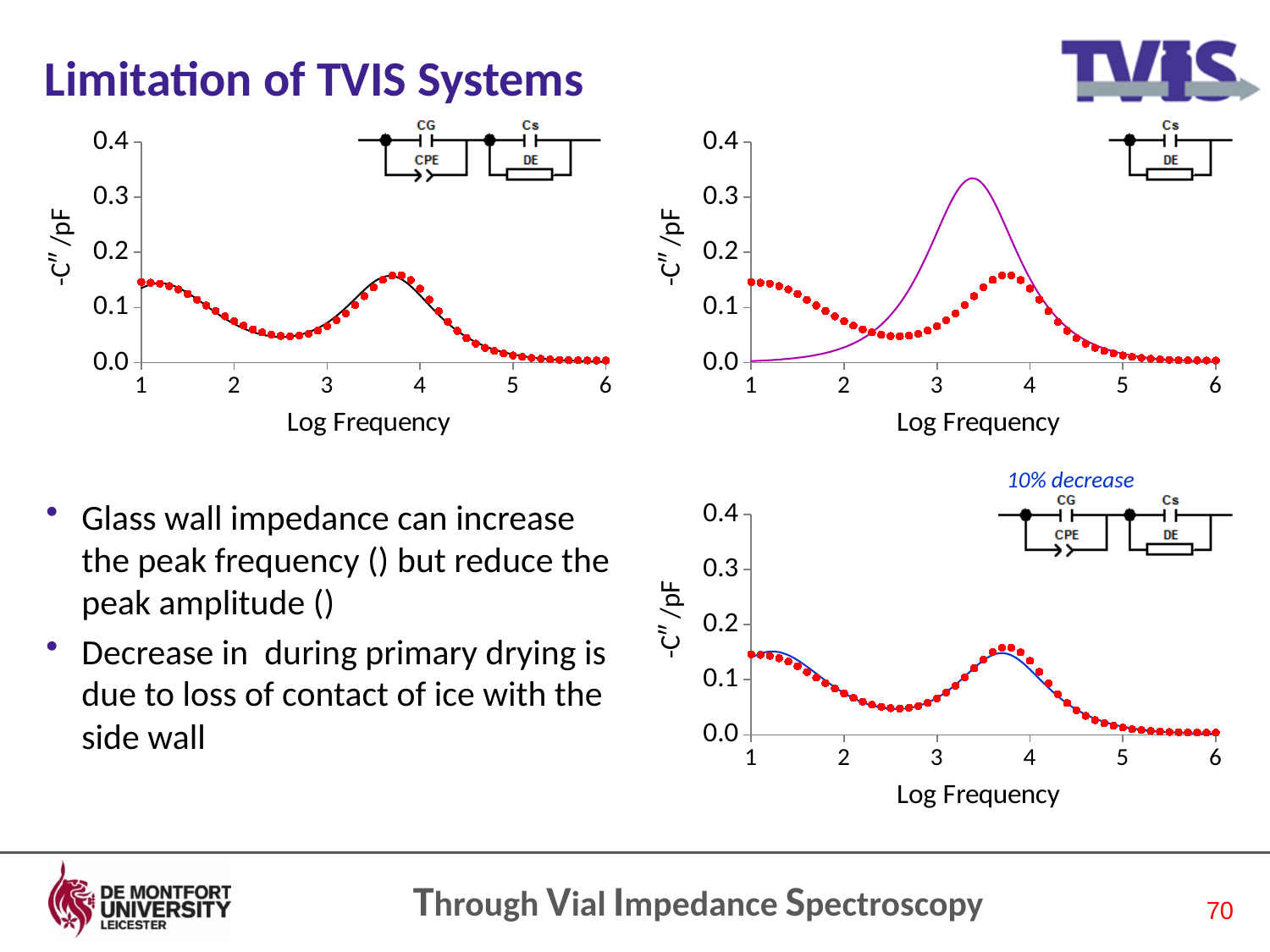
What is the x-axis label of the top-right chart? Log Frequency In the top-right chart, is the peak value of the purple line greater or less than 0.3? greater What kind of chart is the top-left chart on the slide? line chart In the top-left chart, do the values of the red dotted series rise or fall between log frequency 1 and log frequency 2.5? fall In the top-right chart, is the value of the purple line at log frequency 1 greater or less than 0.1? less In the bottom-right chart, do the values of the red dotted series rise or fall between log frequency 2.5 and log frequency 3.7? rise In the bottom-right chart, is the value of the red dotted series at log frequency 6 greater or less than 0.1? less What is the y-axis label of the bottom-right chart? -C'' /pF How many charts are shown on the slide? 3 In the top-right chart, which series reaches a higher peak, the purple line or the red dots? the purple line